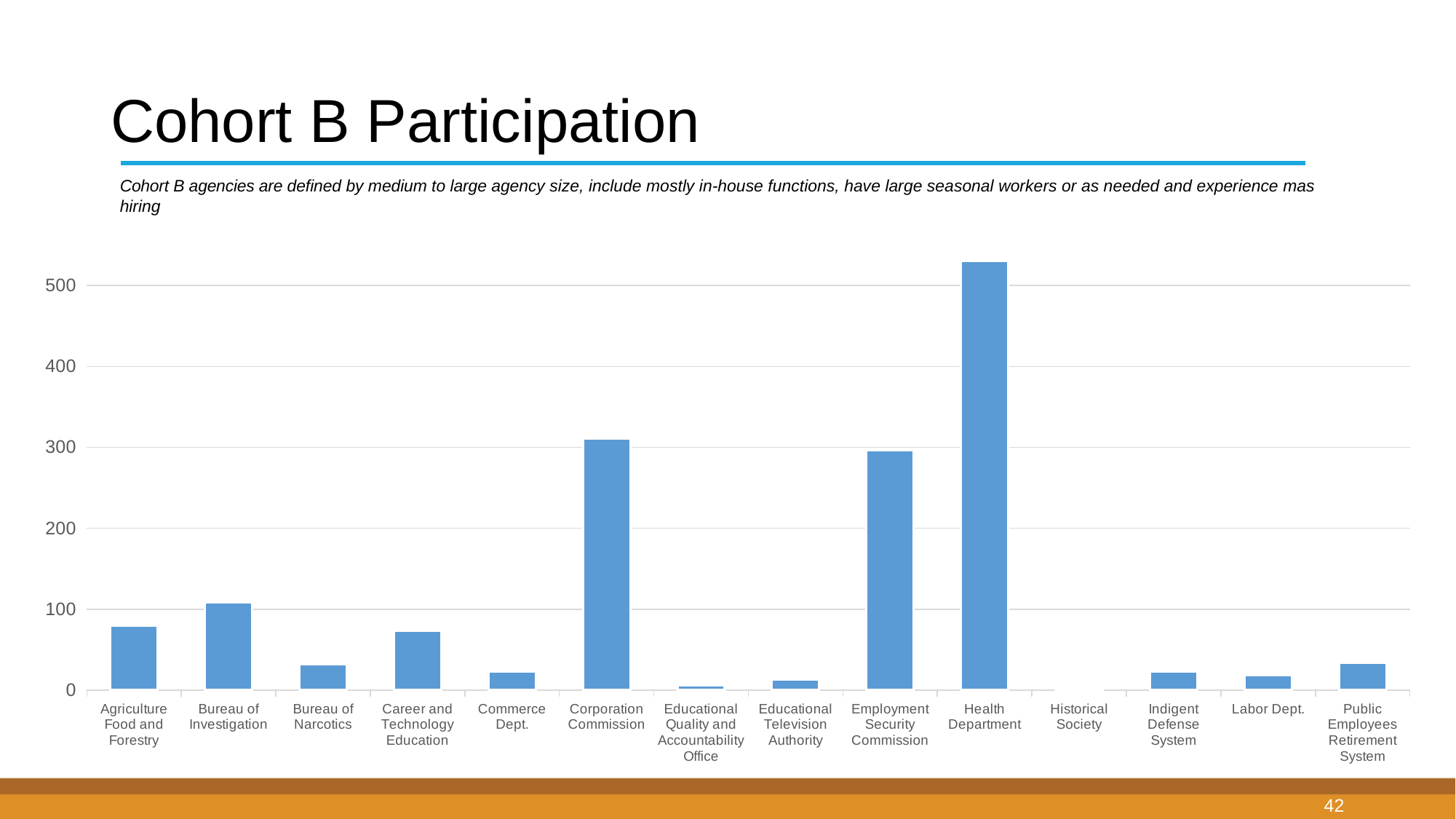
What kind of chart is shown on the slide? Bar chart Which has the larger value, Career and Technology Education or Commerce Dept.? Career and Technology Education Is the value for Bureau of Narcotics greater or less than 100? less Is the value for Employment Security Commission greater or less than 200? greater What is the title of the slide containing the chart? Cohort B Participation How many agencies are shown on the x axis of the chart? 14 Is the value for Health Department greater or less than 500? greater Which agency has the highest value in the chart? Health Department Which has the larger value, Agriculture Food and Forestry or Bureau of Investigation? Bureau of Investigation